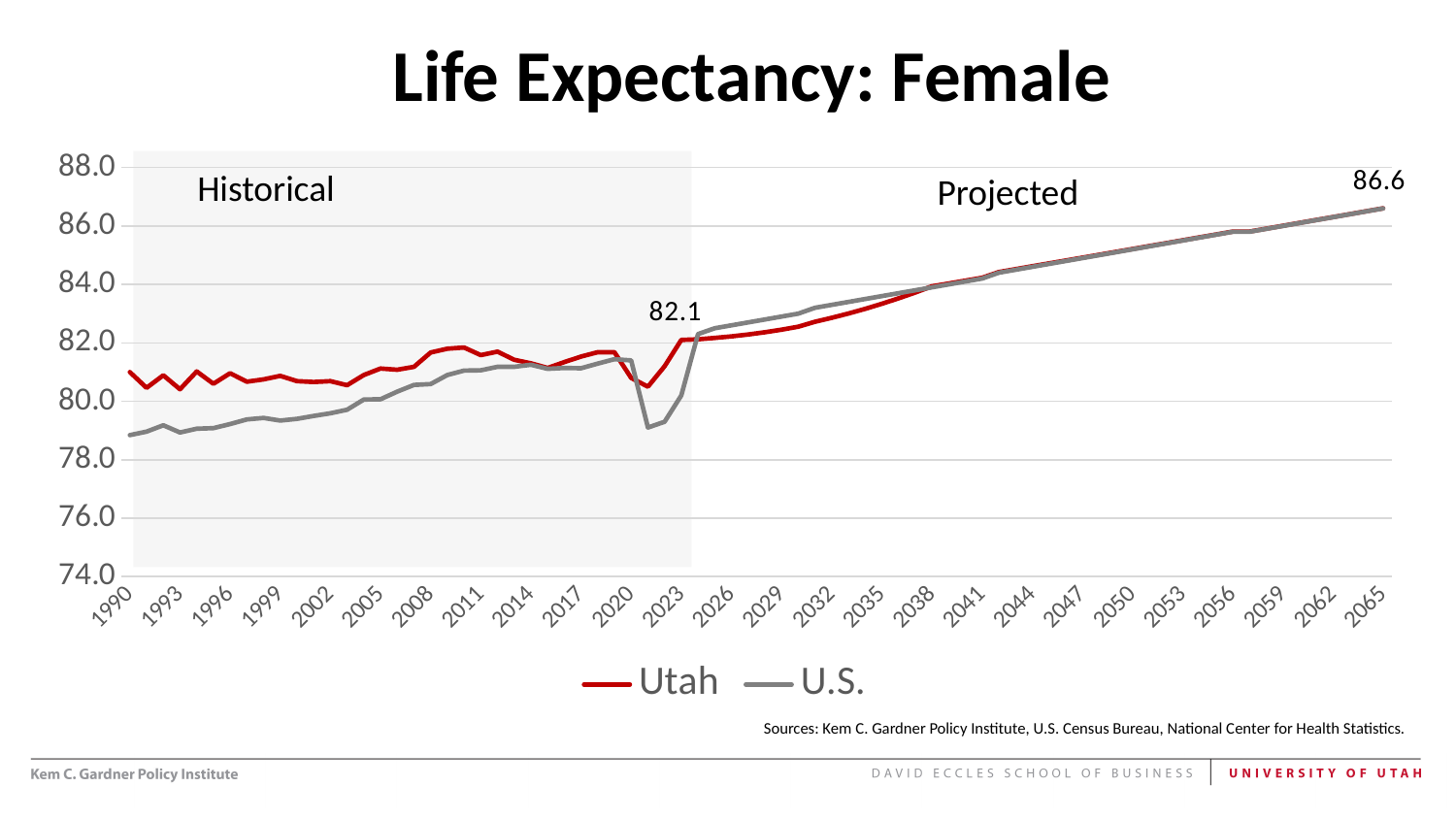
In 1990, which series has the higher life expectancy, Utah or U.S.? Utah What value is labeled on the Utah line at the start of the projected period (around 2023)? 82.1 Is the Utah value in 2050 greater or less than 84.0? greater How many series does the legend list? 2 Is the Utah value in 1990 greater or less than 80.0? greater What are the two series named in the legend? Utah and U.S. What is the title of the chart? Life Expectancy: Female Do the values in the projected period (2026 to 2065) rise or fall over time? rise Is the U.S. value in 1990 greater or less than 80.0? less What value is labeled at the right end of the chart in 2065? 86.6 What type of chart is shown on the slide? line chart What is the difference between the labeled value in 2065 (86.6) and the labeled value of 82.1? 4.5